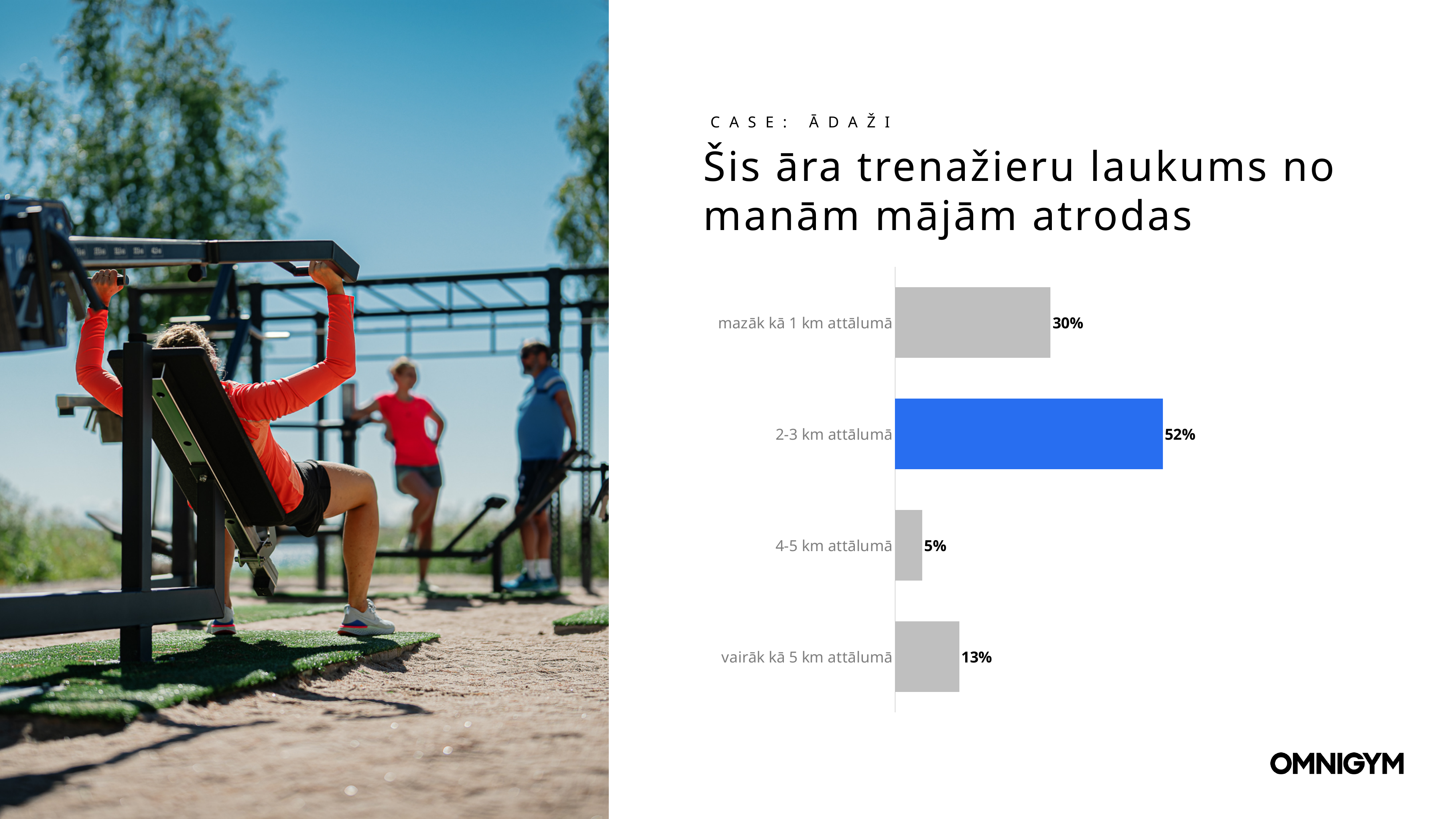
Which is larger, the value for "mazāk kā 1 km attālumā" or "vairāk kā 5 km attālumā"? mazāk kā 1 km attālumā What is the difference between the values for "2-3 km attālumā" and "mazāk kā 1 km attālumā"? 22% What is the value for "4-5 km attālumā"? 5% What is the value for "vairāk kā 5 km attālumā"? 13% What is the difference between the values for "vairāk kā 5 km attālumā" and "4-5 km attālumā"? 8% What is the value for "mazāk kā 1 km attālumā"? 30% What kind of chart is shown on the slide? bar chart How many categories does the chart show? 4 Which category has the highest value? 2-3 km attālumā What is the value for "2-3 km attālumā"? 52% Which category has the lowest value? 4-5 km attālumā Which bar is highlighted in blue? 2-3 km attālumā